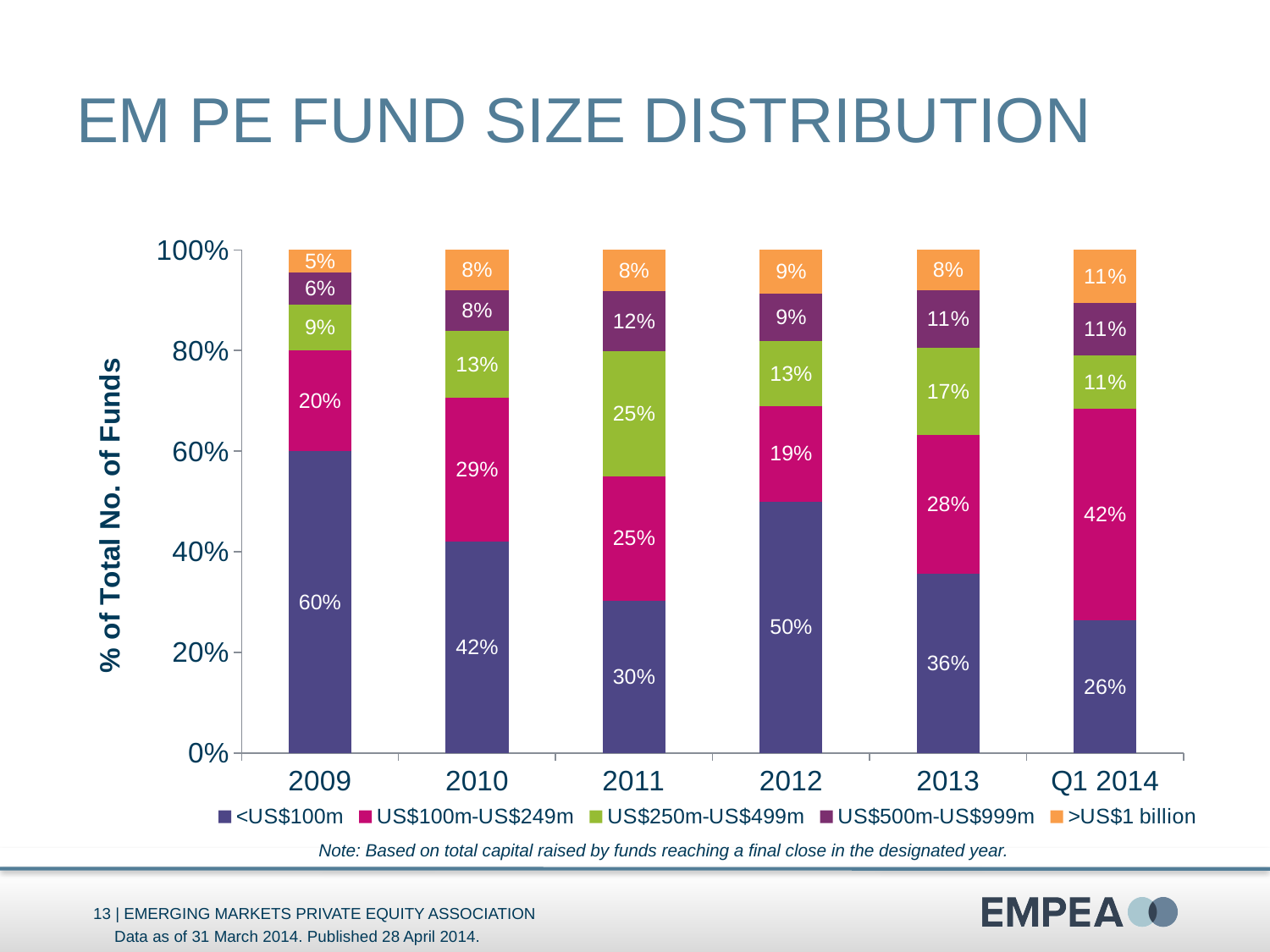
What share of funds were US$100m-US$249m in Q1 2014? 42% What type of chart is shown? Stacked bar chart What is the label of the y axis? % of Total No. of Funds What share of funds were US$250m-US$499m in 2011? 25% How many time periods are shown on the x axis? 6 In which period was the <US$100m share of funds lowest? Q1 2014 How many fund size categories does the legend list? 5 What share of funds were <US$100m in 2009? 60% In which year was the <US$100m share of funds highest? 2009 What is the difference between the <US$100m share in 2012 and in 2013? 14% Which is larger: the US$500m-US$999m share in 2011 or in 2012? 2011 What share of funds were >US$1 billion in 2012? 9%